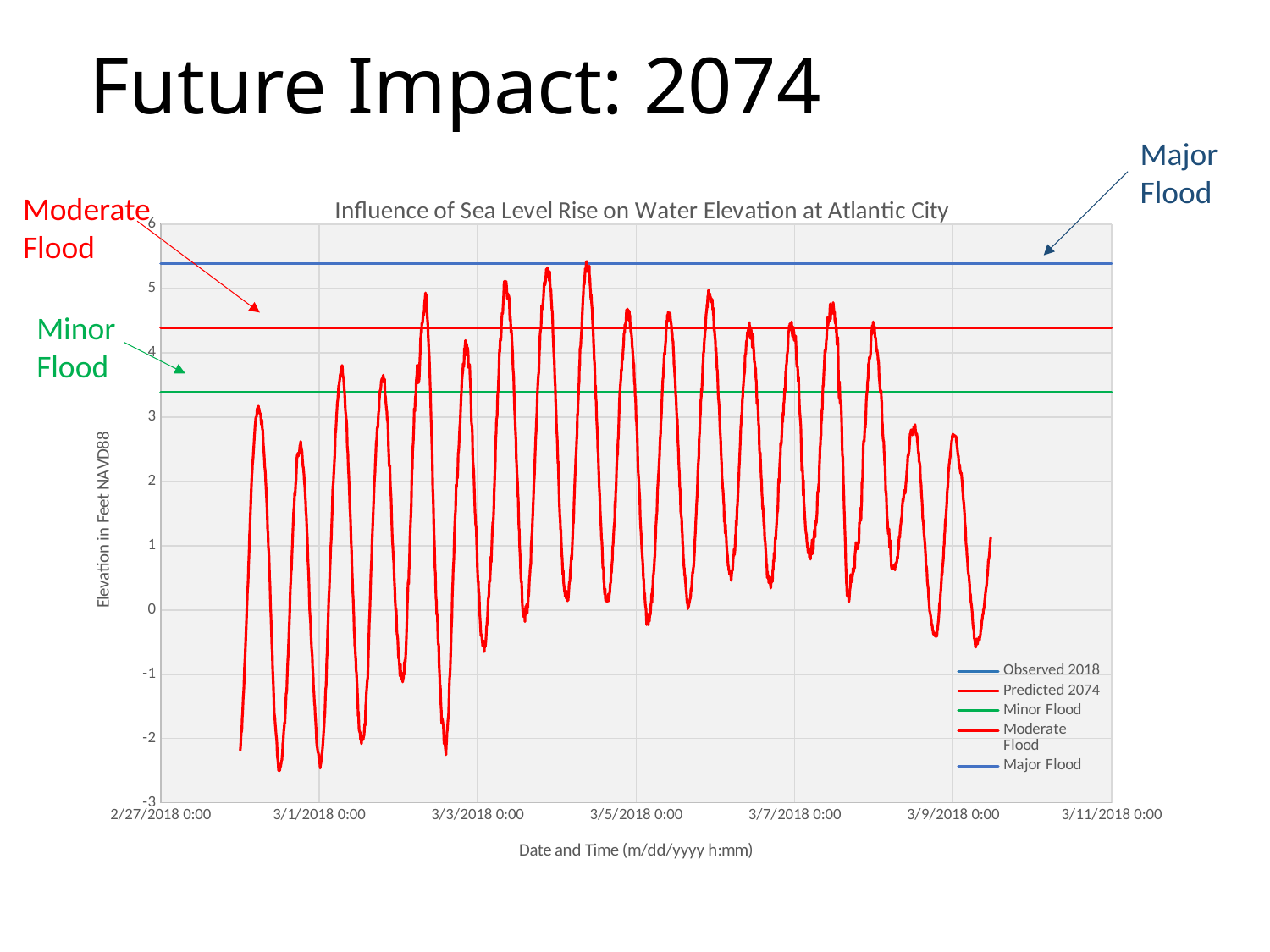
Is the highest peak of the Predicted 2074 series greater or less than 5? greater Which line is higher on the chart, Moderate Flood or Minor Flood? Moderate Flood Which line is higher on the chart, Major Flood or Minor Flood? Major Flood Is the value of the Major Flood line greater or less than 5? greater How many series does the chart legend list? 5 Is the value of the Minor Flood line greater or less than 3? greater What kind of chart is shown on the slide? Line chart Does the Predicted 2074 series ever rise above the Moderate Flood line? Yes What is the label of the vertical axis? Elevation in Feet NAVD88 What is the title of the chart? Influence of Sea Level Rise on Water Elevation at Atlantic City